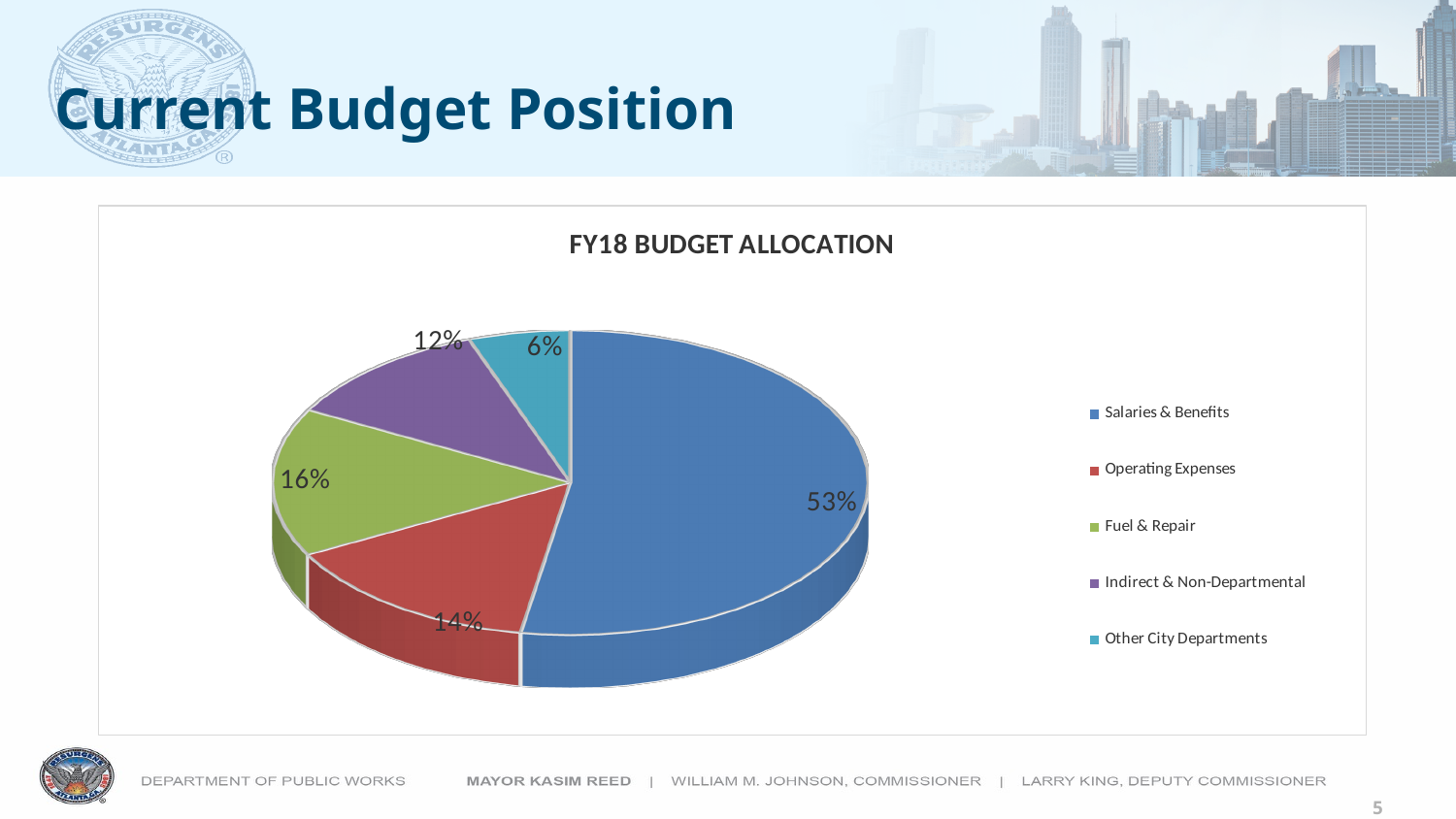
What share of the FY18 budget allocation goes to Fuel & Repair? 16% What share of the FY18 budget allocation goes to Other City Departments? 6% What share of the FY18 budget allocation goes to Indirect & Non-Departmental? 12% How many categories does the legend list? 5 What is the difference in percentage points between Salaries & Benefits and Fuel & Repair? 37 What share of the FY18 budget allocation goes to Salaries & Benefits? 53% Which category has the smallest share of the FY18 budget allocation? Other City Departments Which is larger, the share for Fuel & Repair or the share for Operating Expenses? Fuel & Repair What type of chart is shown on the slide? Pie chart What is the title of the chart? FY18 BUDGET ALLOCATION Which category has the largest share of the FY18 budget allocation? Salaries & Benefits What share of the FY18 budget allocation goes to Operating Expenses? 14%